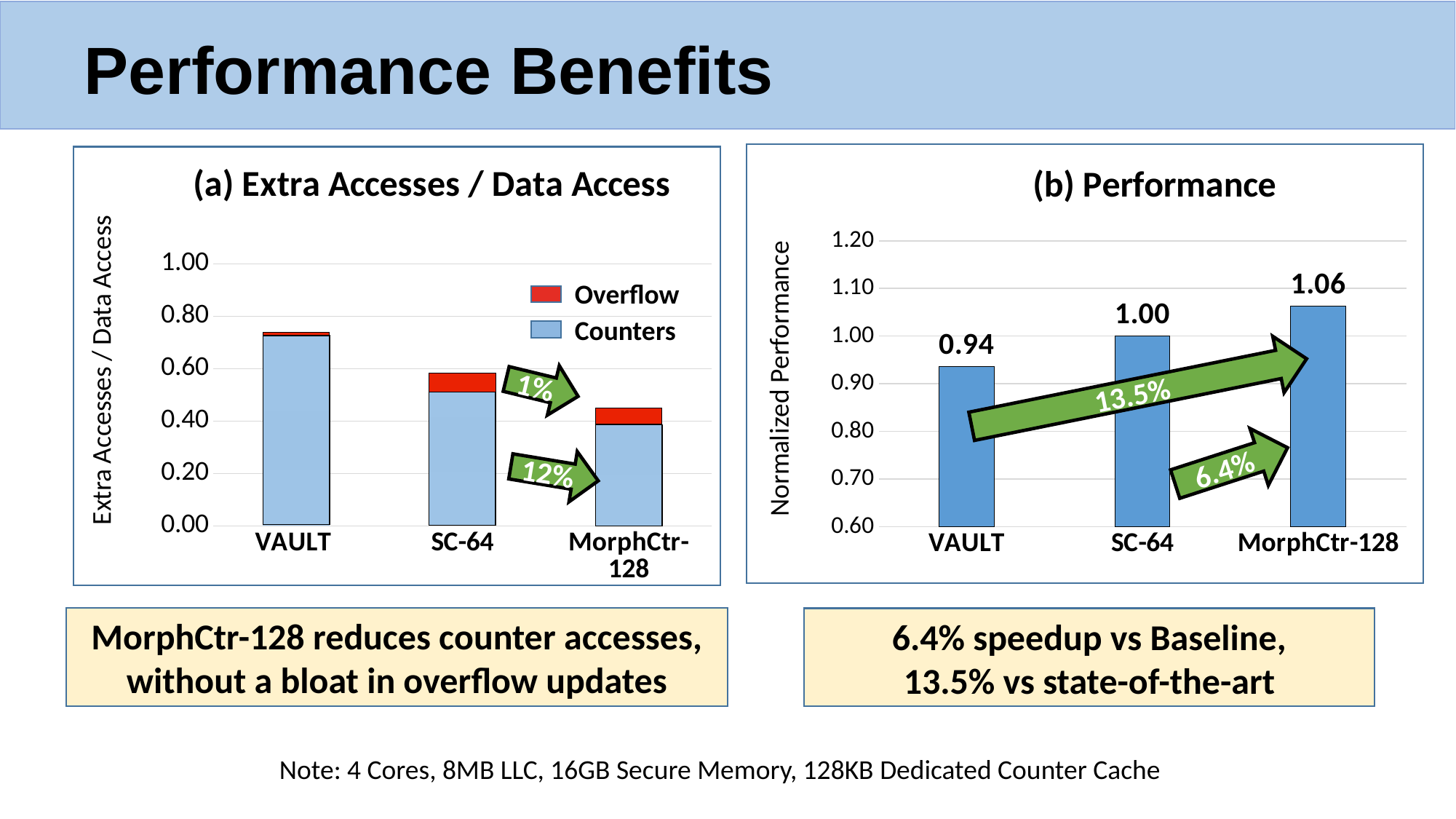
In chart (b) Performance, which category has the lowest normalized performance? VAULT In chart (a) Extra Accesses / Data Access, which category has the tallest stacked bar? VAULT In chart (a) Extra Accesses / Data Access, which category has the shortest stacked bar? MorphCtr-128 In chart (b) Performance, what is the difference between the normalized performance of MorphCtr-128 and VAULT? 0.12 In chart (a) Extra Accesses / Data Access, is the total value for MorphCtr-128 greater or less than 0.60? less In chart (b) Performance, which category has the highest normalized performance? MorphCtr-128 What type of chart is chart (b) Performance? bar chart In chart (b) Performance, what is the normalized performance for VAULT? 0.94 In chart (b) Performance, do the values rise or fall from VAULT to MorphCtr-128 along the x axis? rise In chart (b) Performance, what is the normalized performance for MorphCtr-128? 1.06 In chart (a) Extra Accesses / Data Access, is the total value for VAULT greater or less than 0.60? greater In chart (a) Extra Accesses / Data Access, how many series does the legend list? 2